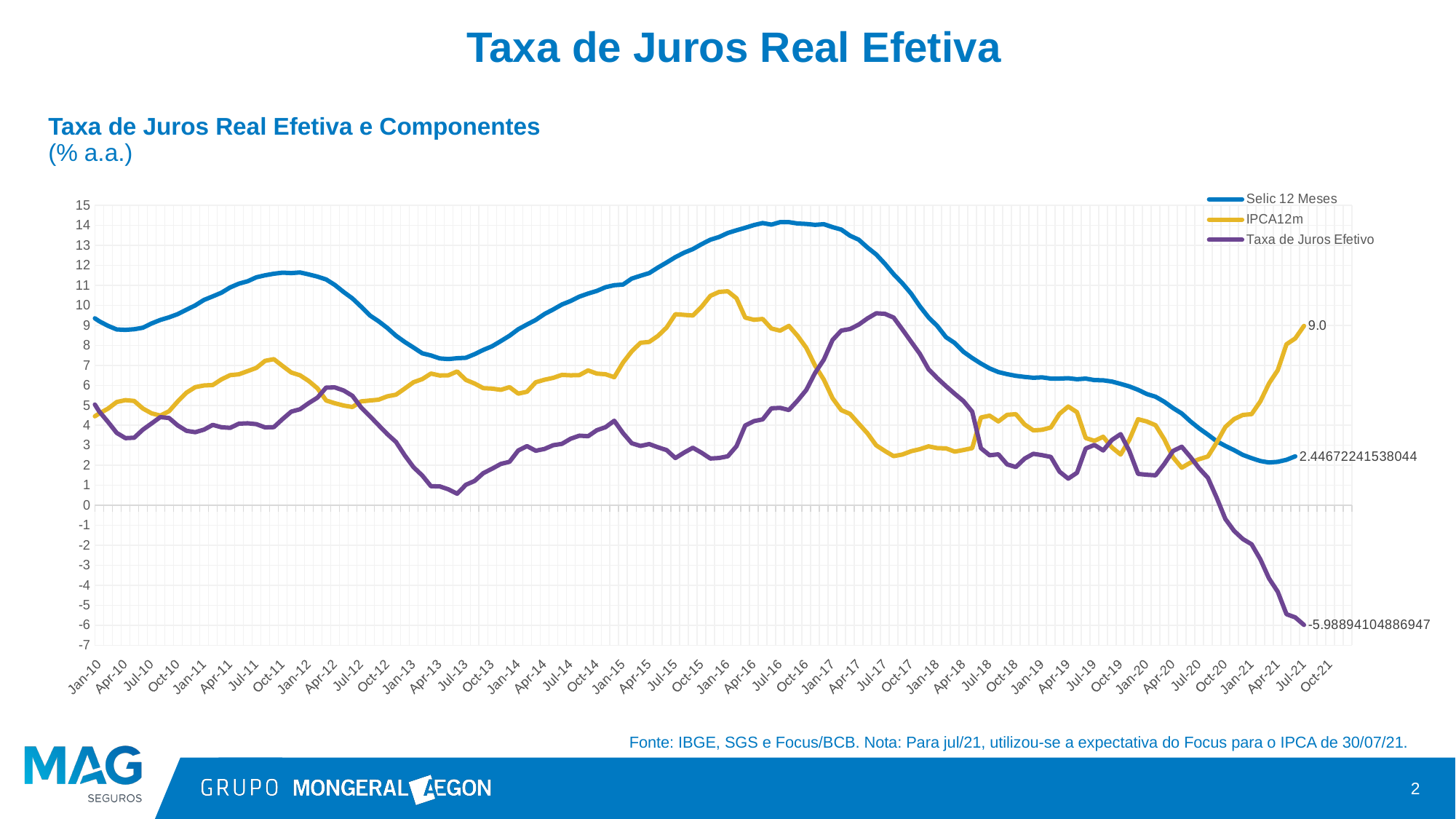
What is the last labelled value of the Selic 12 Meses series? 2.44672241538044 Is the value of IPCA12m at Jan-16 greater or less than 10? greater What kind of chart is shown on the slide? line chart Which series reaches the lowest value on the chart? Taxa de Juros Efetivo Is the value of Taxa de Juros Efetivo at Jul-13 greater or less than 2? less Is the value of Selic 12 Meses at Jul-16 greater or less than 13? greater What is the last labelled value of the Taxa de Juros Efetivo series? -5.98894104886947 What is the last labelled value of the IPCA12m series? 9.0 Does the Selic 12 Meses series rise or fall between Jul-16 and Jul-21? fall At the end of the chart (Jul-21), which is higher: IPCA12m or Selic 12 Meses? IPCA12m How many series does the legend list? 3 What is the title of the chart? Taxa de Juros Real Efetiva e Componentes